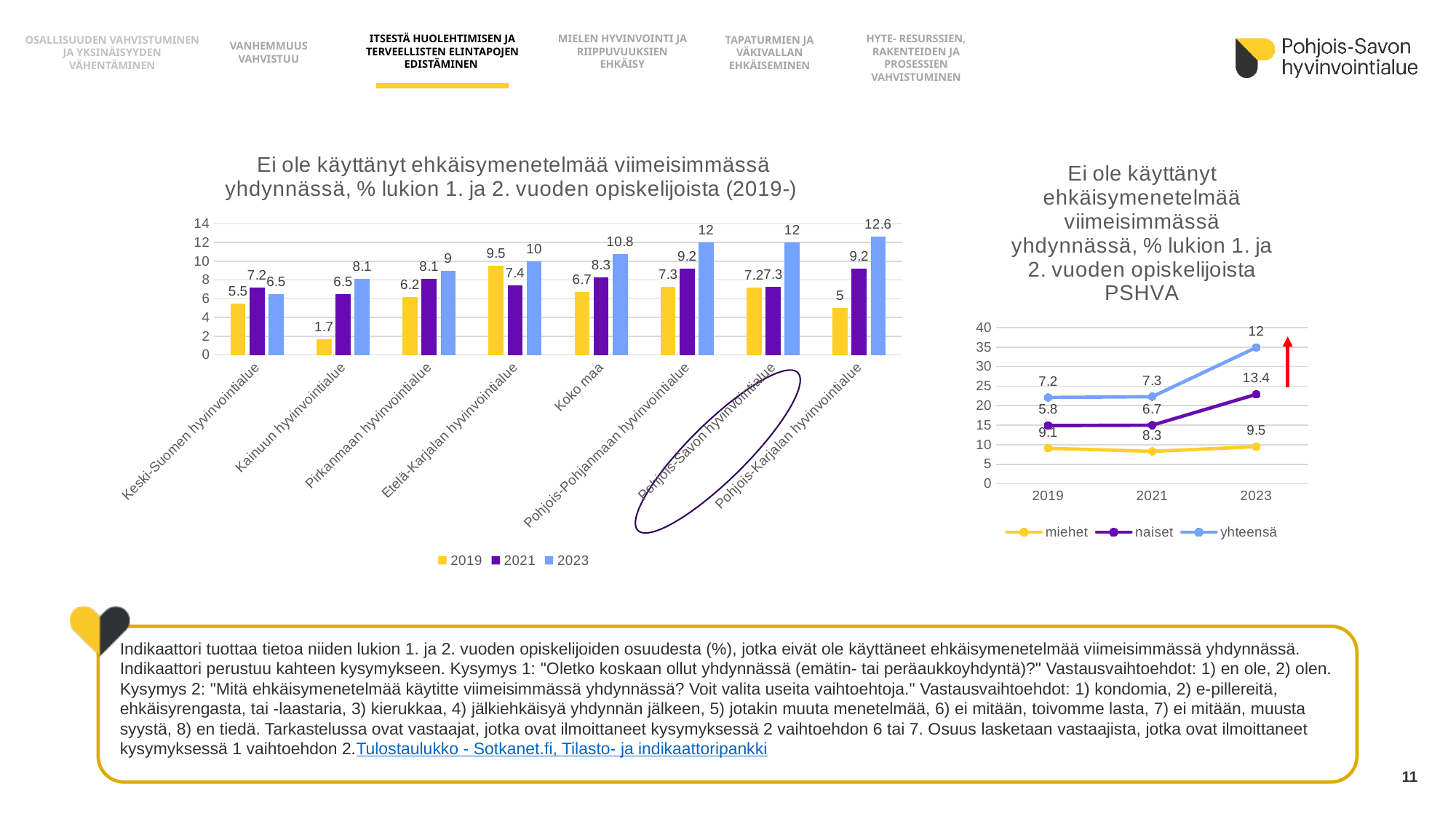
In the left bar chart, what is the 2019 value for Kainuun hyvinvointialue? 1.7 In the left bar chart, which category has the lowest 2019 value? Kainuun hyvinvointialue What kind of chart is the right chart titled "... PSHVA"? Line chart In the left bar chart, which has the larger 2023 value: Koko maa or Etelä-Karjalan hyvinvointialue? Koko maa In the right line chart (PSHVA), what is the value for yhteensä in 2023? 12 What kind of chart is the left chart titled "Ei ole käyttänyt ehkäisymenetelmää viimeisimmässä yhdynnässä, % lukion 1. ja 2. vuoden opiskelijoista (2019-)"? Bar chart In the right line chart (PSHVA), does the yhteensä series rise or fall from 2021 to 2023? Rise In the left bar chart, how many series does the legend list? 3 In the left bar chart, what is the difference between the 2023 and 2019 values for Pohjois-Savon hyvinvointialue? 4.8 In the left bar chart, what is the 2021 value for Pirkanmaan hyvinvointialue? 8.1 In the left bar chart, which category has the highest 2023 value? Pohjois-Karjalan hyvinvointialue In the left bar chart, how many categories (areas) are shown on the x axis? 8